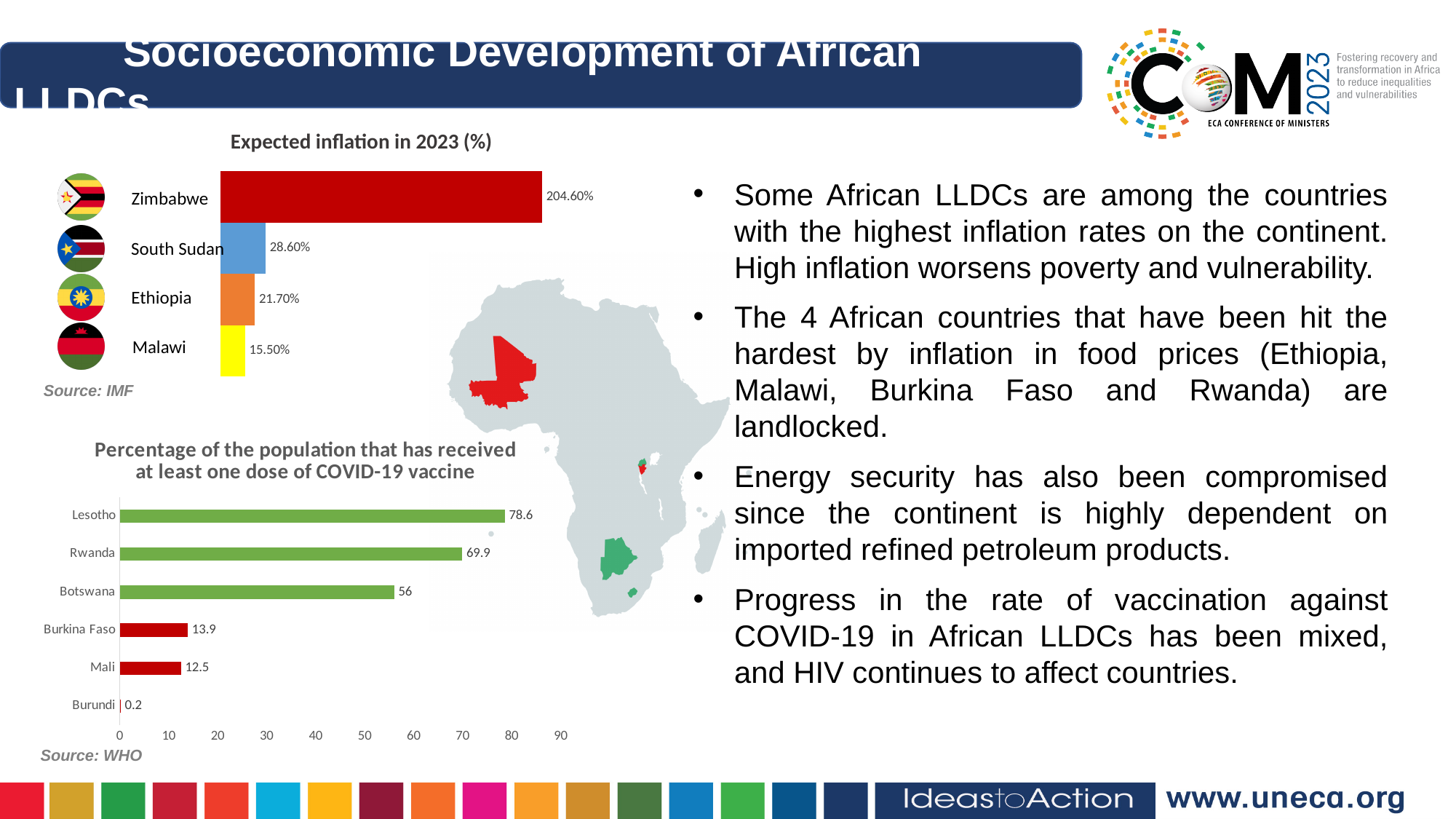
In the COVID-19 vaccine chart, how many countries are shown? 6 What kind of chart is the COVID-19 vaccine chart? Bar chart In the 'Expected inflation in 2023 (%)' chart, what is the value for Zimbabwe? 204.60% In the COVID-19 vaccine chart, which country has the lowest value? Burundi In the 'Expected inflation in 2023 (%)' chart, what is the value for Ethiopia? 21.70% In the COVID-19 vaccine chart, what is the difference between Rwanda and Burkina Faso? 56 In the 'Expected inflation in 2023 (%)' chart, which country has the lowest expected inflation? Malawi In the 'Expected inflation in 2023 (%)' chart, how many countries are shown? 4 In the COVID-19 vaccine chart, what percentage of the population in Lesotho has received at least one dose? 78.6 In the COVID-19 vaccine chart, what is the value for Botswana? 56 In the 'Expected inflation in 2023 (%)' chart, what is the difference between South Sudan and Malawi? 13.10% In the 'Expected inflation in 2023 (%)' chart, which is larger, South Sudan or Ethiopia? South Sudan